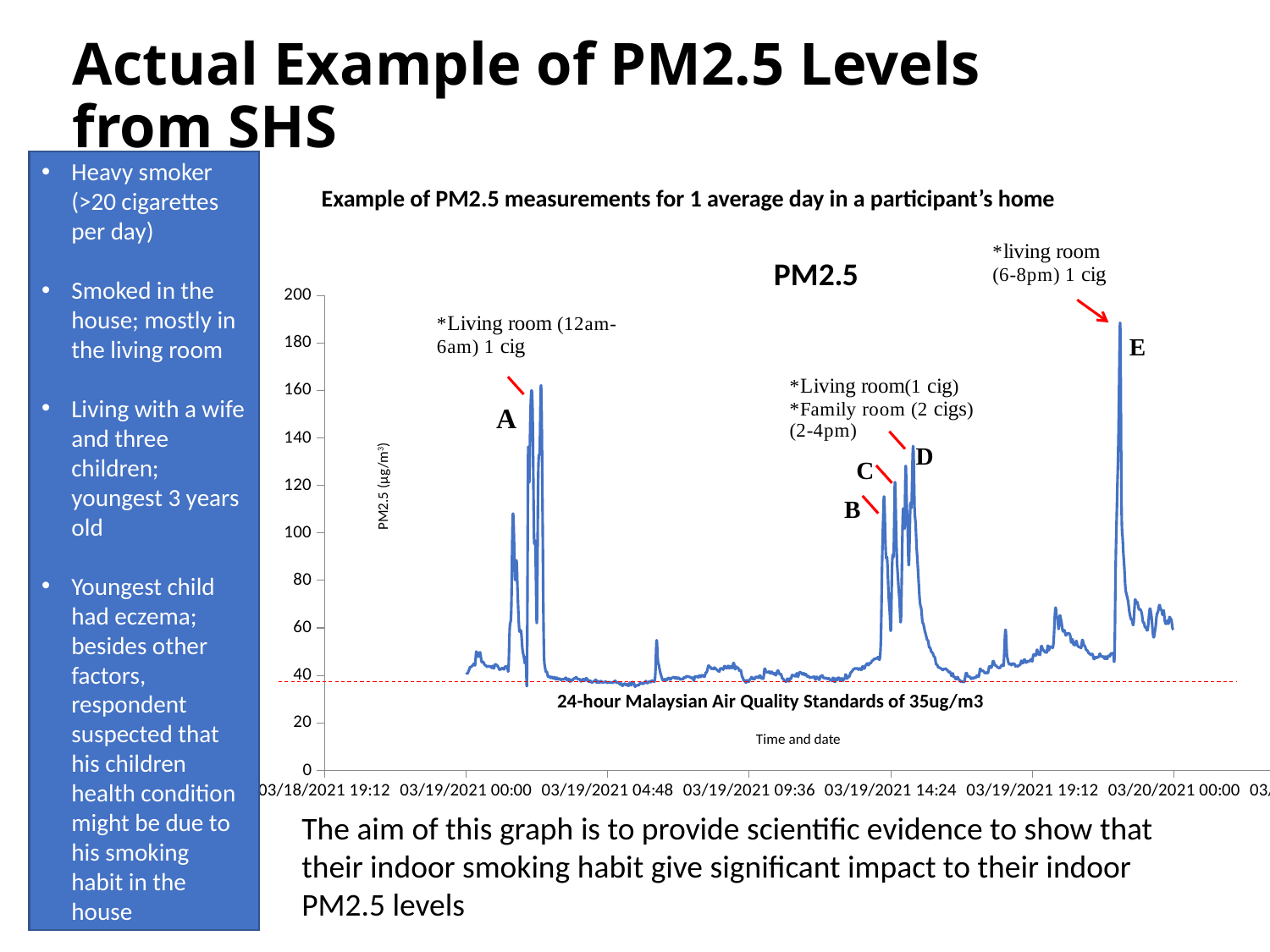
What is the label on the vertical axis of the chart? PM2.5 (µg/m3) What value does the dashed reference line for the 24-hour Malaysian Air Quality Standard represent? 35ug/m3 Is the PM2.5 value at peak B greater or less than 100? greater Is the PM2.5 value at peak A greater or less than 140? greater Is the PM2.5 value at peak D greater or less than 160? less What is the title printed above the plotted line in the chart? PM2.5 How many labelled peaks (letters) are marked on the chart? 5 Which peak is higher, A or D? A What kind of chart is shown on the slide? line chart Which labelled peak (A, B, C, D or E) reaches the highest PM2.5 value? E